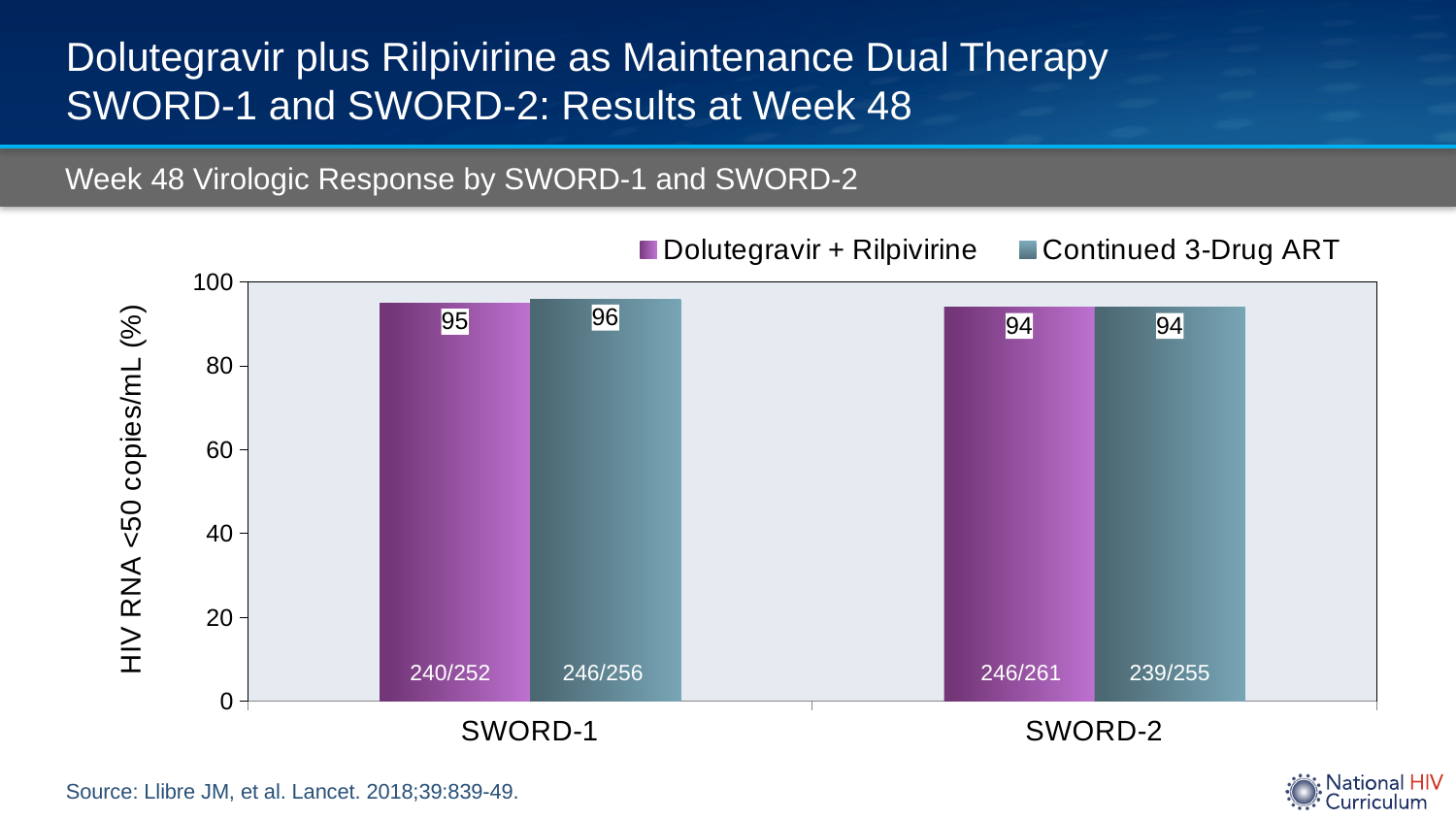
Is the value for Dolutegravir + Rilpivirine in SWORD-2 greater or less than 80? greater What fraction is printed on the Dolutegravir + Rilpivirine bar for SWORD-1? 240/252 How many series does the legend list? 2 What is the value for Continued 3-Drug ART in SWORD-2? 94 What kind of chart is shown on the slide? Bar chart What is the value for Dolutegravir + Rilpivirine in SWORD-1? 95 What is the label of the y axis? HIV RNA <50 copies/mL (%) What fraction is printed on the Continued 3-Drug ART bar for SWORD-2? 239/255 What is the value for Dolutegravir + Rilpivirine in SWORD-2? 94 What is the difference between the Continued 3-Drug ART and Dolutegravir + Rilpivirine values in SWORD-1? 1 What is the value for Continued 3-Drug ART in SWORD-1? 96 How many study groups (categories) are shown on the x axis? 2